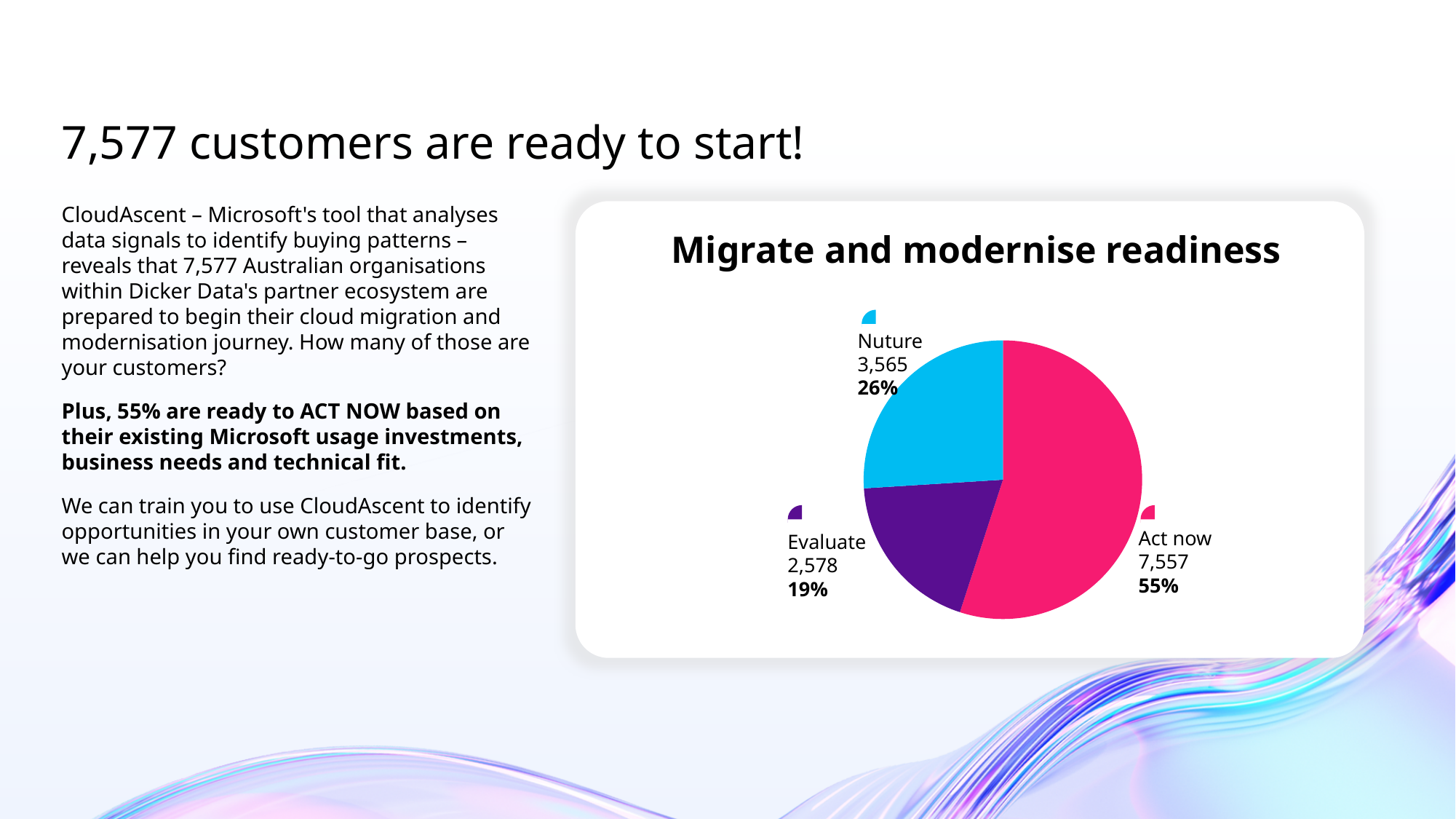
What is the value shown for the Nuture slice? 3,565 Which is larger, the Nuture slice or the Evaluate slice? Nuture What share of the pie does the Act now slice represent? 55% Which slice is the largest? Act now Which slice is the smallest? Evaluate What is the difference between the Act now value and the Nuture value? 3,992 How many slices does the pie chart have? 3 What share of the pie does the Evaluate slice represent? 19% What is the title of the chart? Migrate and modernise readiness What is the value shown for the Evaluate slice? 2,578 What kind of chart is shown on the slide? Pie chart What is the value shown for the Act now slice? 7,557